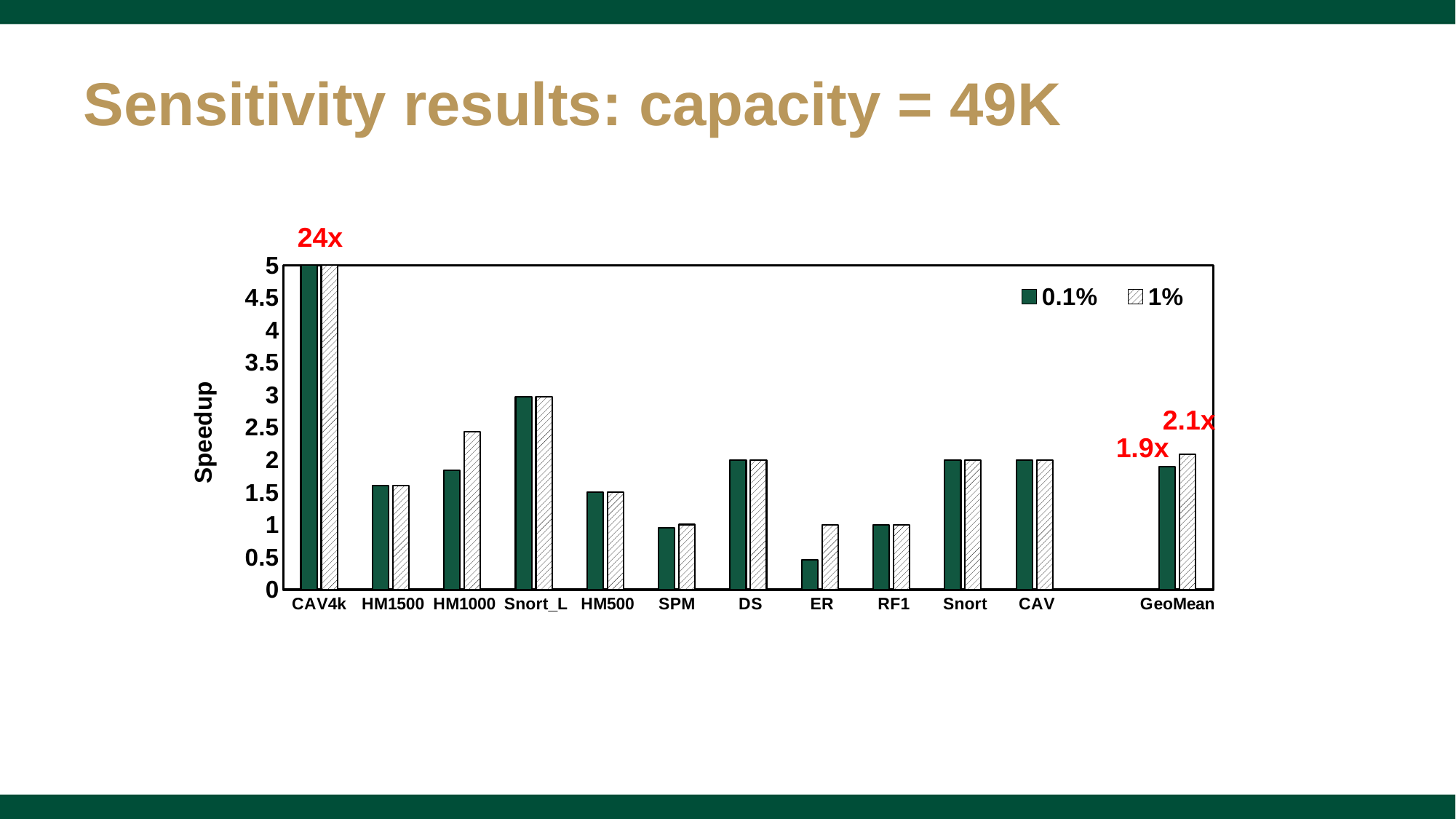
How many categories are shown on the x axis? 12 For HM1000, which series has the larger speedup, 0.1% or 1%? 1% How many series does the legend list? 2 Is the 0.1% speedup for ER greater or less than 1? less Is the 0.1% speedup for Snort_L greater or less than 2.5? greater What is the speedup for GeoMean in the 0.1% series? 1.9x What is the difference between the 1% and 0.1% GeoMean speedups? 0.2x Which category has the lowest speedup in the 0.1% series? ER Which category has the highest speedup? CAV4k What kind of chart is shown on the slide? bar chart What is the speedup for GeoMean in the 1% series? 2.1x What speedup value is labelled above the CAV4k bars? 24x